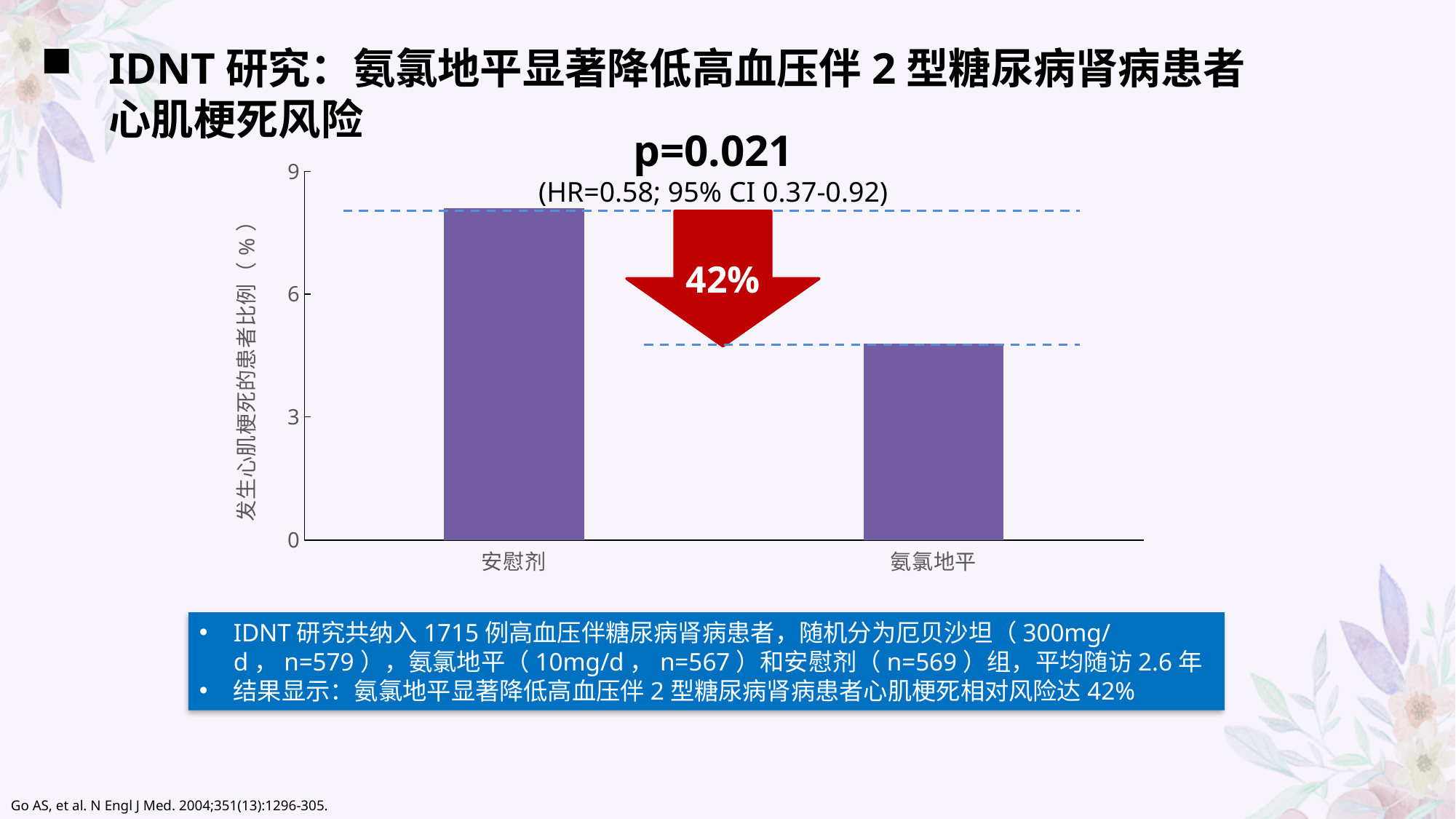
Is the value for 安慰剂 greater or less than 6? greater What is the highest tick value shown on the y axis? 9 Is the value for 氨氯地平 greater or less than 6? less What kind of chart is shown on the slide? bar chart What is the label of the y axis of the chart? 发生心肌梗死的患者比例（%） What p-value is printed above the chart? p=0.021 Which category has the higher bar, 安慰剂 or 氨氯地平? 安慰剂 Which category has the lowest value in the chart? 氨氯地平 Which category has the highest value in the chart? 安慰剂 Is the value for 氨氯地平 greater or less than 3? greater How many categories (bars) does the chart show? 2